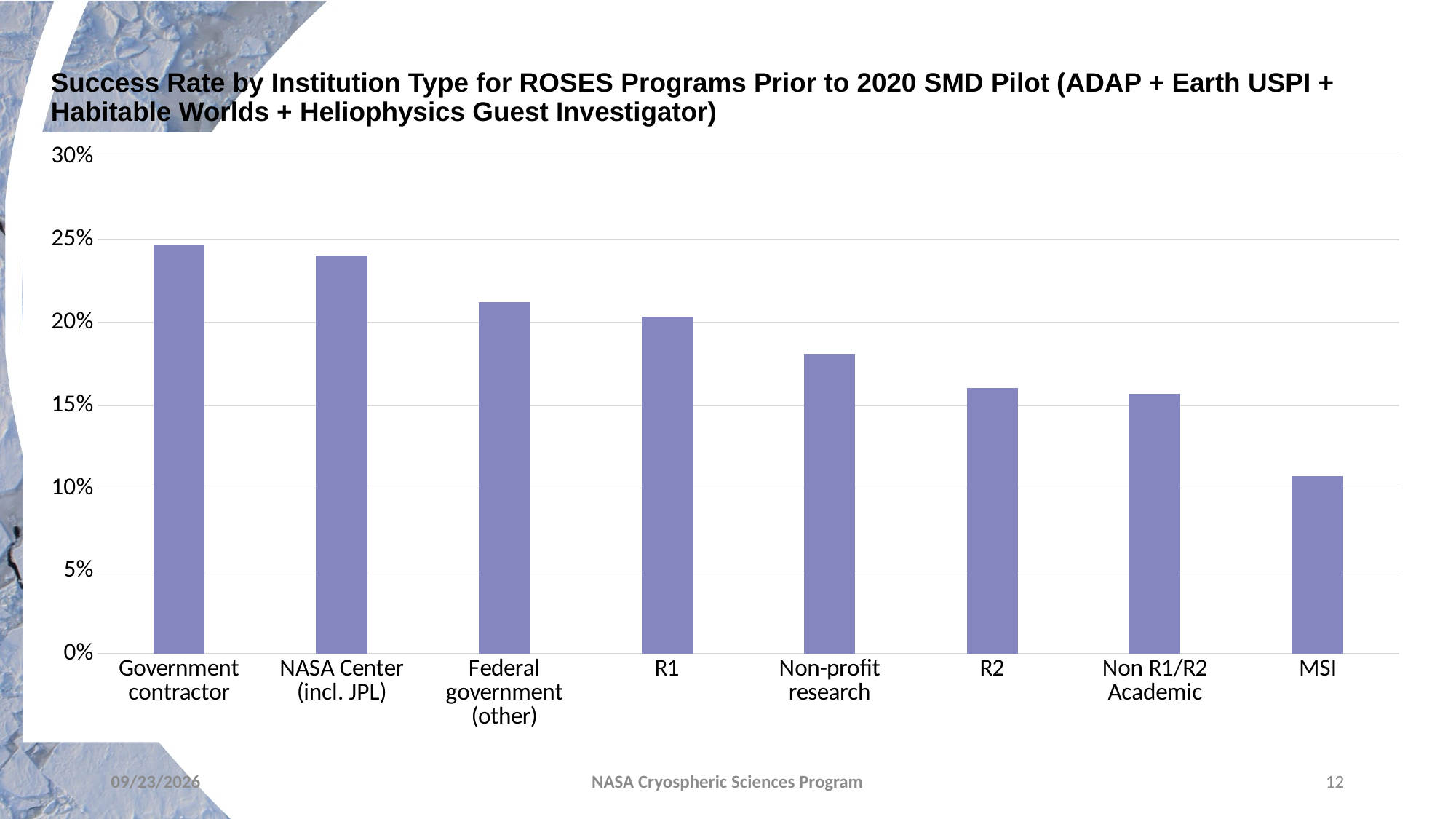
What is the highest value shown on the vertical axis of the chart? 30% What kind of chart is shown on the slide? bar chart Is the success rate for Non-profit research greater or less than 15%? greater How many institution types are shown on the x axis of the chart? 8 Which has a higher success rate, R1 or Non-profit research? R1 Which institution type has the lowest success rate? MSI Is the success rate for Federal government (other) greater or less than 20%? greater Which has a higher success rate, R2 or Federal government (other)? Federal government (other) Is the success rate for MSI greater or less than 15%? less Do the success rates rise or fall moving from left to right across the institution types? fall Which institution type has the highest success rate? Government contractor